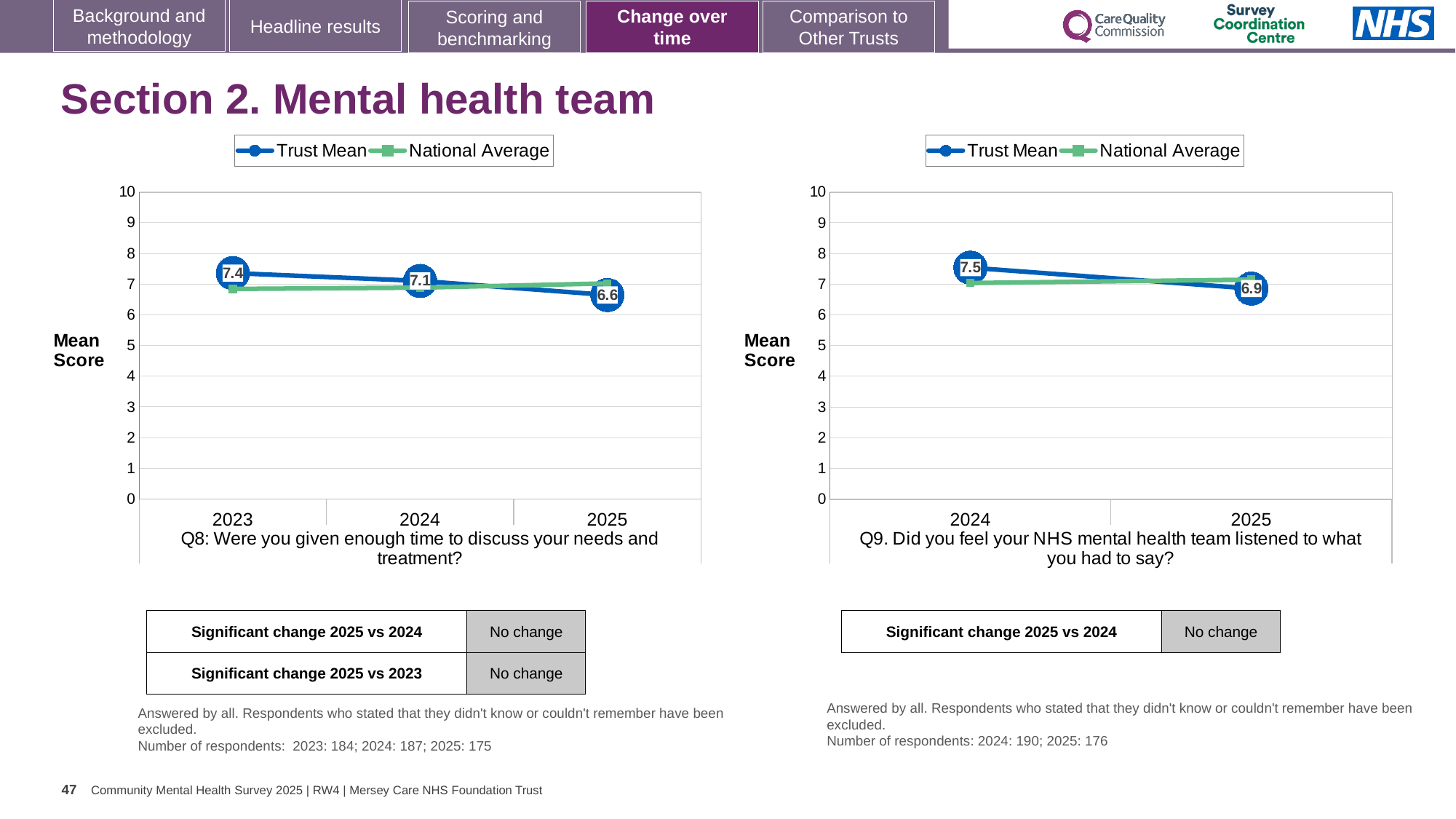
In the Q8 chart on the left, which year has the highest Trust Mean? 2023 In the Q8 chart on the left, which is larger in 2023, the Trust Mean or the National Average? Trust Mean In the Q8 chart on the left, by how much did the Trust Mean fall from 2023 to 2025? 0.8 In the Q9 chart on the right, what is the Trust Mean for 2025? 6.9 In the Q8 chart on the left, which year has the lowest Trust Mean? 2025 In the Q9 chart on the right, what is the difference between the Trust Mean in 2024 and 2025? 0.6 In the Q9 chart on the right, what is the Trust Mean for 2024? 7.5 In the Q8 chart on the left, what is the Trust Mean for 2025? 6.6 In the Q8 chart on the left, what is the Trust Mean for 2023? 7.4 How many years are plotted on the x axis of the Q9 chart on the right? 2 In the Q8 chart on the left, does the Trust Mean rise or fall from 2023 to 2025? fall How many series does the legend of the Q8 chart on the left list? 2